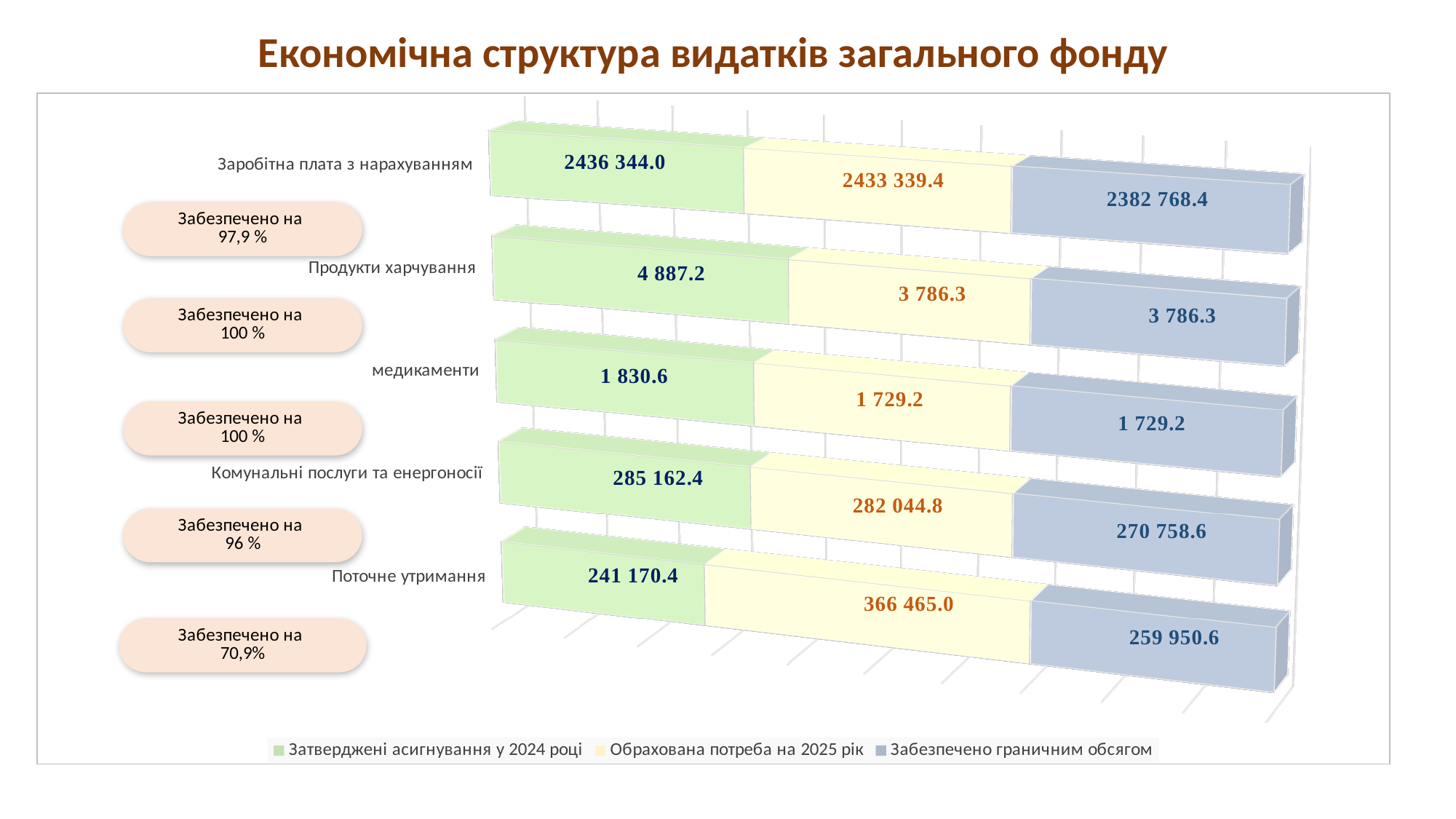
For «Поточне утримання», which is larger: «Затверджені асигнування у 2024 році» or «Обрахована потреба на 2025 рік»? Обрахована потреба на 2025 рік Which category has the lowest value of «Забезпечено граничним обсягом»? медикаменти How many series does the legend list? 3 How many categories are shown in the chart? 5 What is the value of «Обрахована потреба на 2025 рік» for «медикаменти»? 1 729.2 Which category has the highest value of «Затверджені асигнування у 2024 році»? Заробітна плата з нарахуванням What is the value of «Затверджені асигнування у 2024 році» for «Продукти харчування»? 4 887.2 What is the value of «Обрахована потреба на 2025 рік» for «Поточне утримання»? 366 465.0 What kind of chart is shown on the slide? bar chart For «Продукти харчування», how much larger is «Затверджені асигнування у 2024 році» than «Обрахована потреба на 2025 рік»? 1 100.9 For «Комунальні послуги та енергоносії», what is the difference between «Обрахована потреба на 2025 рік» and «Забезпечено граничним обсягом»? 11 286.2 What is the value of «Забезпечено граничним обсягом» for «Заробітна плата з нарахуванням»? 2382 768.4